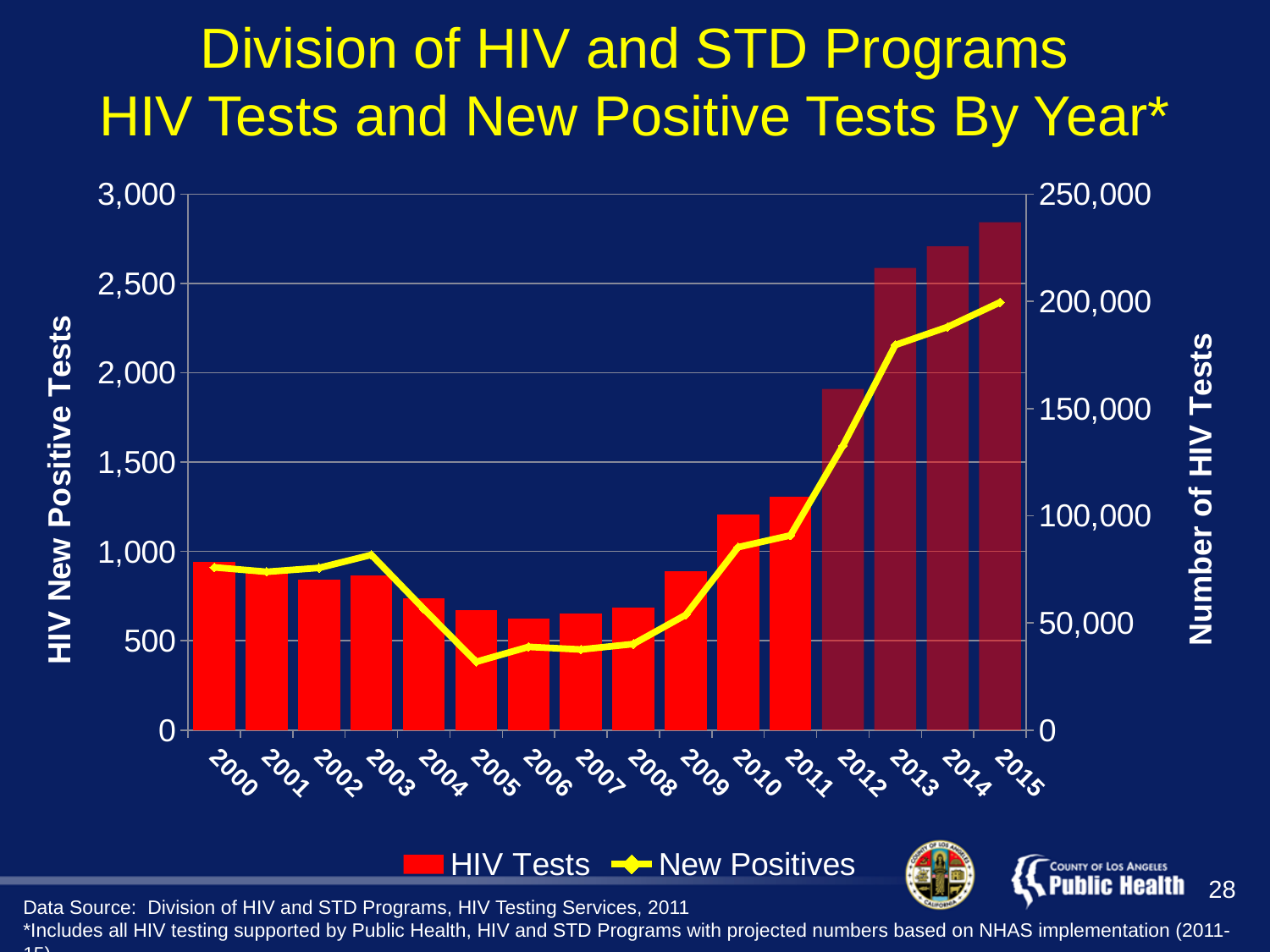
How many series does the legend list? 2 Which year has the lowest number of New Positives? 2005 Which year has more HIV Tests, 2011 or 2012? 2012 Is the number of HIV Tests in 2013 greater or less than 200,000? greater Is the number of HIV Tests in 2005 greater or less than 100,000? less What kind of chart is shown on the slide? A combined bar and line chart How many years are shown on the x axis? 16 Do the New Positives rise or fall from 2011 to 2015? rise Which year has the highest number of HIV Tests? 2015 Which year has the highest number of New Positives? 2015 Is the number of New Positives in 2015 greater or less than 2,000? greater